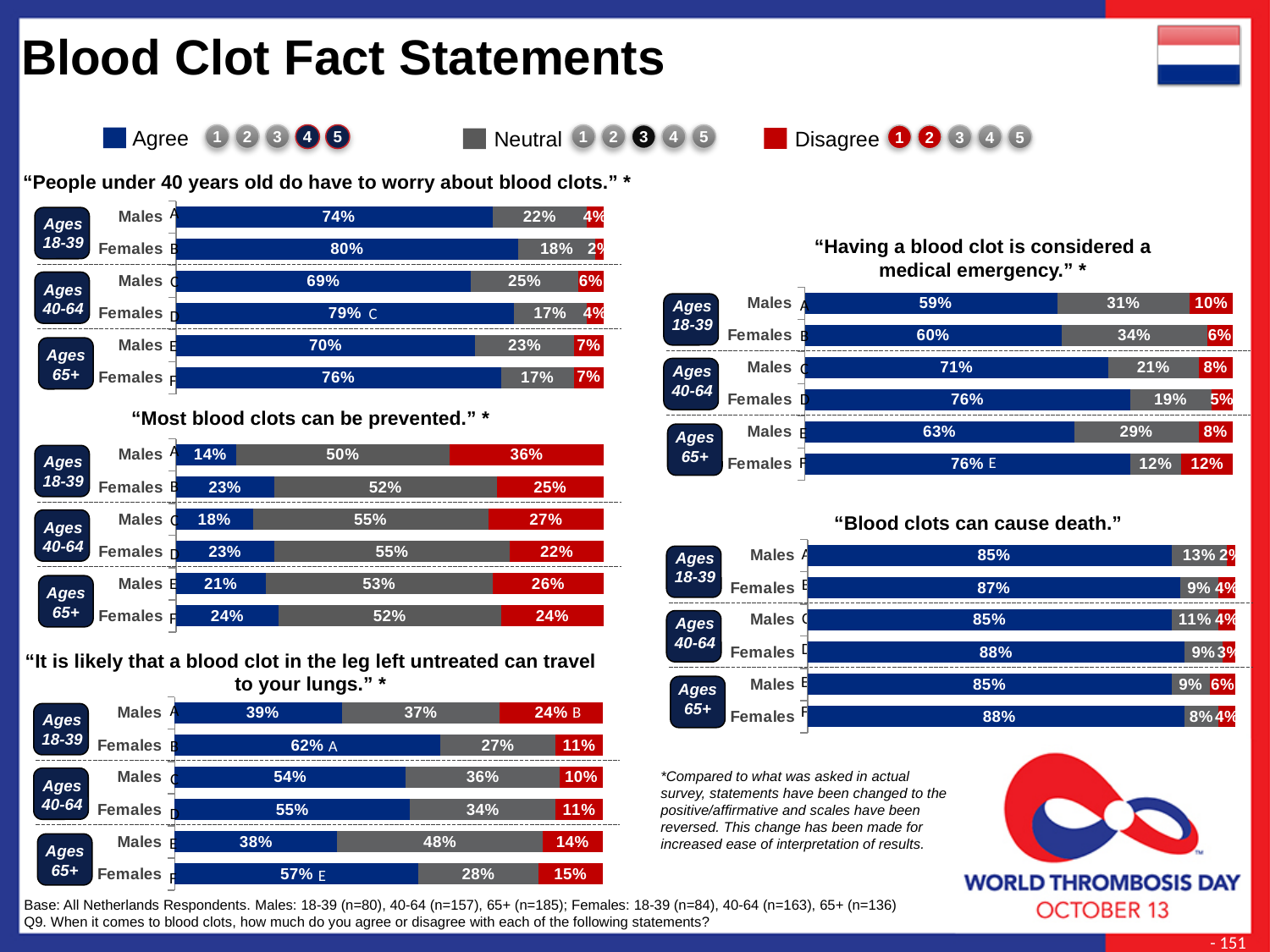
In the chart "It is likely that a blood clot in the leg left untreated can travel to your lungs.", what is the difference between the Agree percentages for Females 18-39 and Males 18-39? 23% What kind of chart is used for "Most blood clots can be prevented."? Stacked bar chart In the chart "Blood clots can cause death.", what is the total of the Agree, Neutral and Disagree percentages for Males aged 18-39? 100% In the chart "Having a blood clot is considered a medical emergency.", which is larger: the Agree percentage for Males 40-64 or for Males 65+? Males 40-64 In the chart "Most blood clots can be prevented.", which group has the highest Agree percentage? Females 65+ In the chart "People under 40 years old do have to worry about blood clots.", which group has the lowest Agree percentage? Males 40-64 In the chart "It is likely that a blood clot in the leg left untreated can travel to your lungs.", what is the Neutral percentage for Males aged 65+? 48% In the chart "Most blood clots can be prevented.", what percentage of Males aged 18-39 disagree? 36% In the chart "People under 40 years old do have to worry about blood clots.", what percentage of Females aged 18-39 agree? 80% How many series does the legend at the top of the slide list? 3 In the chart "Having a blood clot is considered a medical emergency.", what percentage of Females aged 65+ disagree? 12% In the chart "Blood clots can cause death.", what percentage of Females aged 40-64 agree? 88%